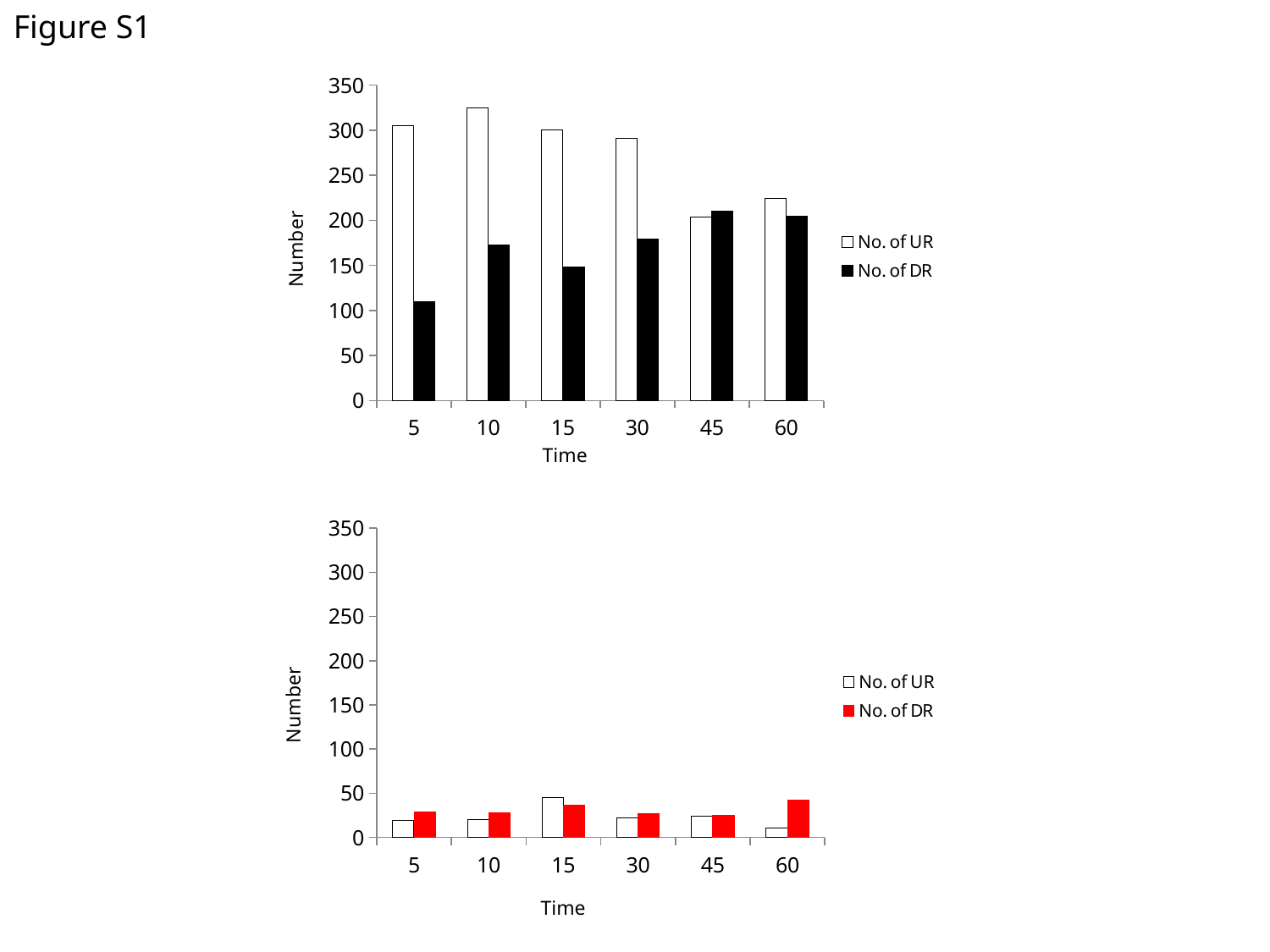
In the bottom chart, at time 60, which is larger: No. of UR or No. of DR? No. of DR In the top chart, at which time is the No. of DR bar lowest? 5 In the bottom chart, what colour are the No. of DR bars? red What kind of chart is the top chart on the slide? bar chart In the top chart, at which time is the No. of UR bar highest? 10 How many time categories are shown on the x axis of the bottom chart? 6 In the top chart, is the No. of UR value at time 10 greater or less than 300? greater In the bottom chart, at which time is the No. of UR bar highest? 15 In the top chart, does the No. of UR series generally rise or fall from time 5 to time 60? fall In the top chart, at time 5, which is larger: No. of UR or No. of DR? No. of UR In the top chart, is the No. of DR value at time 5 greater or less than 150? less How many series does the legend of the top chart list? 2